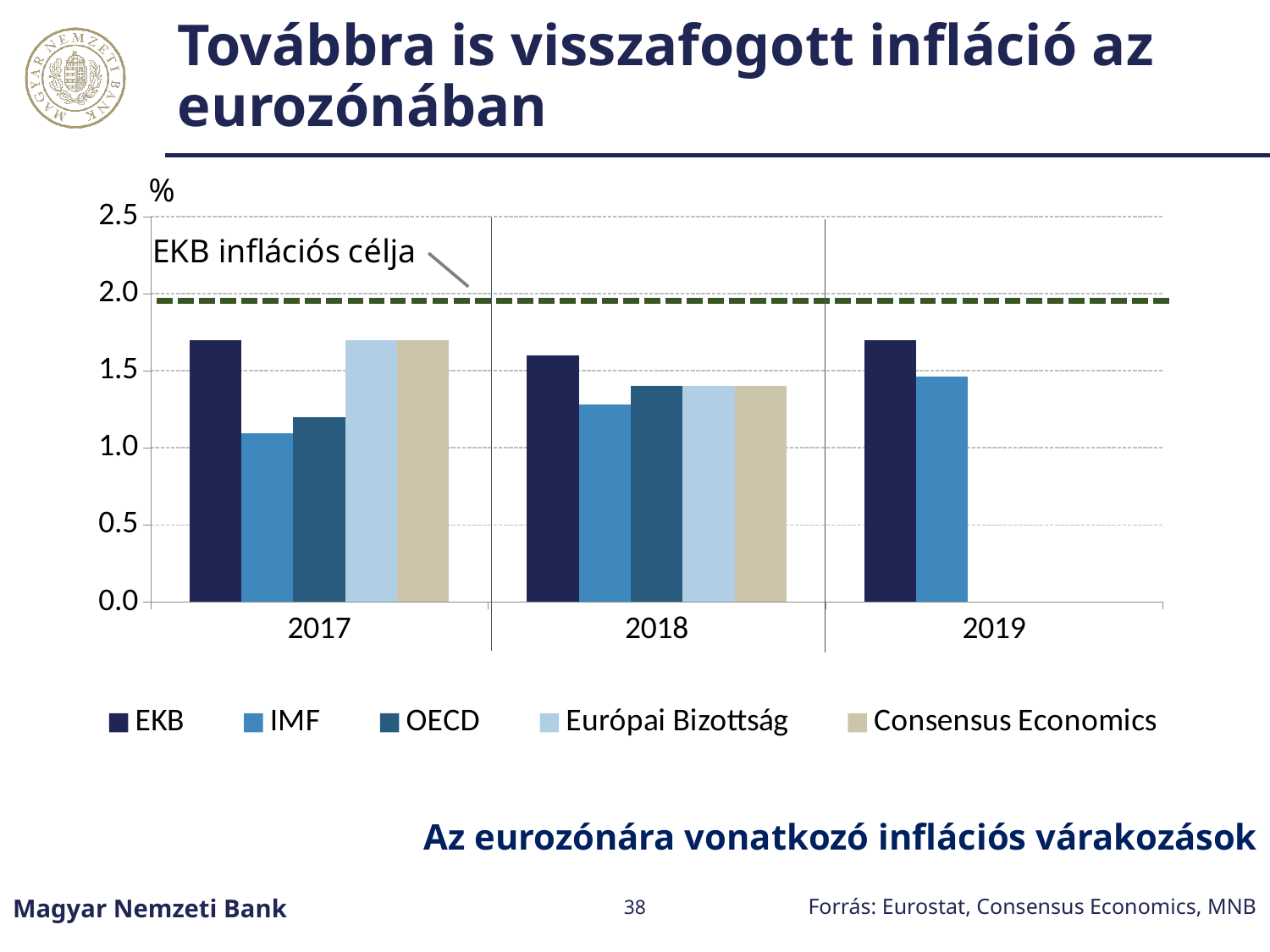
Is the value for IMF in 2018 greater or less than 1.0? greater Is the value for IMF in 2017 greater or less than 1.5? less How many series does the legend list? 5 What kind of chart is shown on the slide? bar chart Is the value for EKB in 2019 greater or less than 2.0? less Which series has the lowest value in 2017? IMF How many year categories are shown on the x axis? 3 Which series has the highest value in 2018? EKB What unit is shown on the y axis? % What does the dashed horizontal line on the chart represent? EKB inflációs célja In 2019, which is larger, the EKB value or the IMF value? EKB